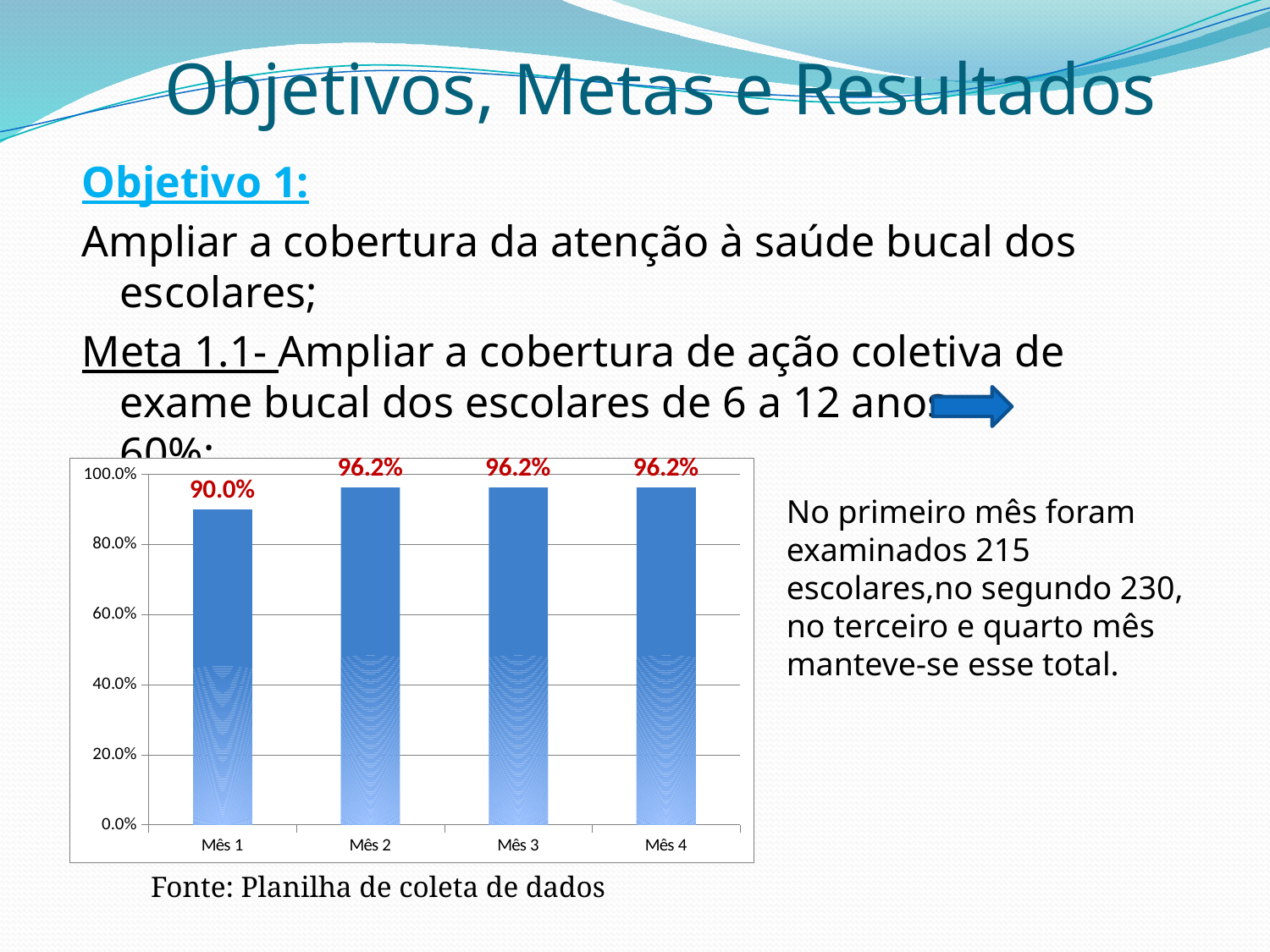
Is the value for Mês 1 greater or less than 80.0%? greater What is the highest tick label on the y axis? 100.0% How many months are shown on the x axis? 4 What kind of chart is shown on the slide? bar chart What is the value for Mês 2? 96.2% Do the values rise or fall from Mês 1 to Mês 2? rise Which month has the lowest value? Mês 1 What colour are the bars in the chart? blue Which is larger, the value for Mês 1 or the value for Mês 3? Mês 3 What is the value for Mês 1? 90.0% What is the value for Mês 4? 96.2% What is the difference between the values for Mês 2 and Mês 1? 6.2%